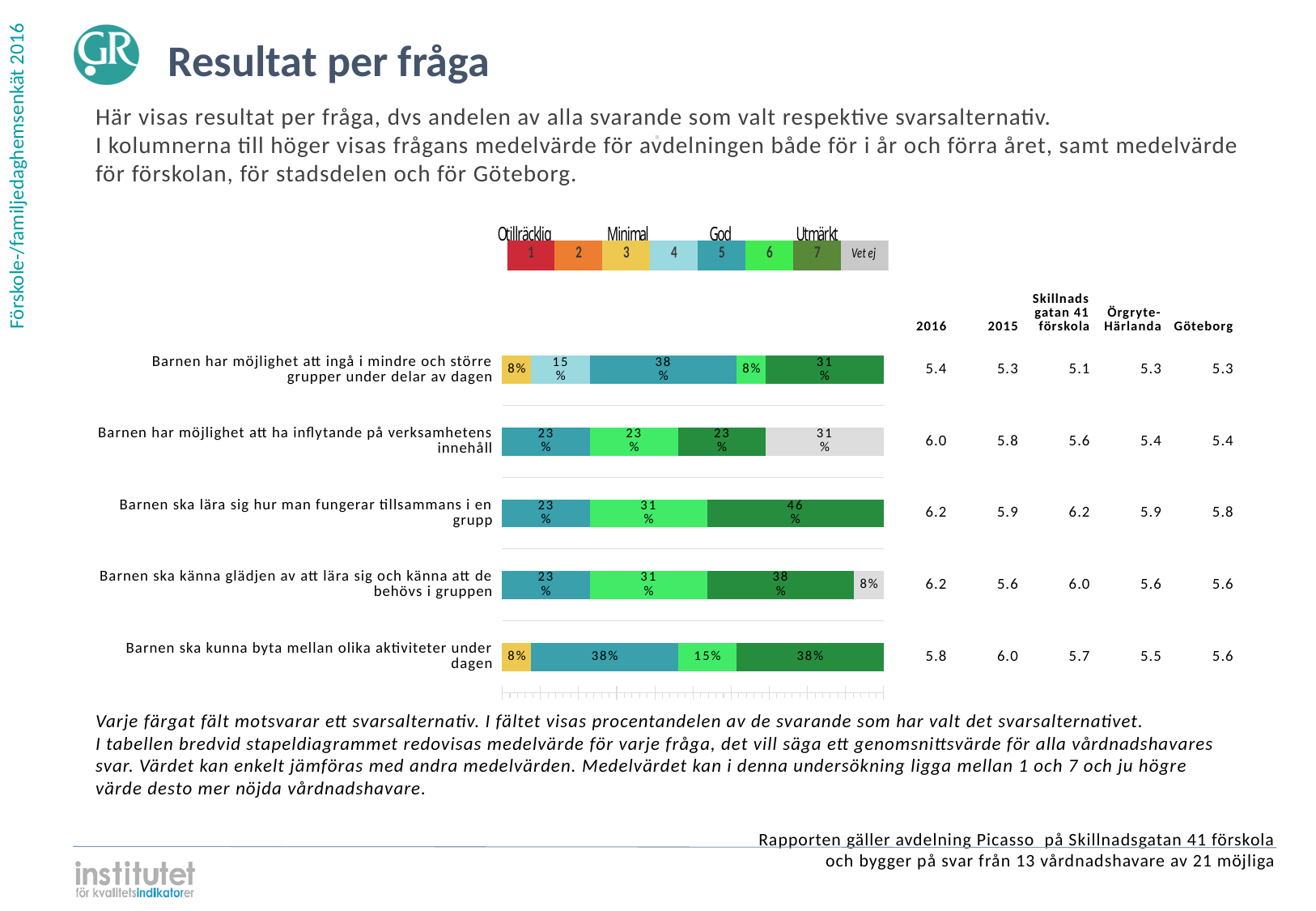
What percentage chose option 5 (teal) for 'Barnen ska kunna byta mellan olika aktiviteter under dagen'? 38% What is the difference between the option 7 share (38%) and the option 6 share (15%) for 'Barnen ska kunna byta mellan olika aktiviteter under dagen'? 23% What is the 2016 mean value shown for 'Barnen ska kunna byta mellan olika aktiviteter under dagen'? 5.8 Which colour in the legend represents response option 1? Red Which question has the largest share of respondents choosing option 7 (dark green)? Barnen ska lära sig hur man fungerar tillsammans i en grupp What percentage of respondents chose option 7 (dark green) for 'Barnen ska lära sig hur man fungerar tillsammans i en grupp'? 46% What percentage chose 'Vet ej' for 'Barnen har möjlighet att ha inflytande på verksamhetens innehåll'? 31% How many response options does the colour legend above the chart list, including 'Vet ej'? 8 How many questions (bars) are shown in the chart? 5 For 'Barnen har möjlighet att ingå i mindre och större grupper under delar av dagen', which is larger: the share for option 5 or the share for option 7? Option 5 What kind of chart is used to show the results per question? Stacked bar chart What is the combined share of options 6 and 7 for 'Barnen ska känna glädjen av att lära sig och känna att de behövs i gruppen'? 69%